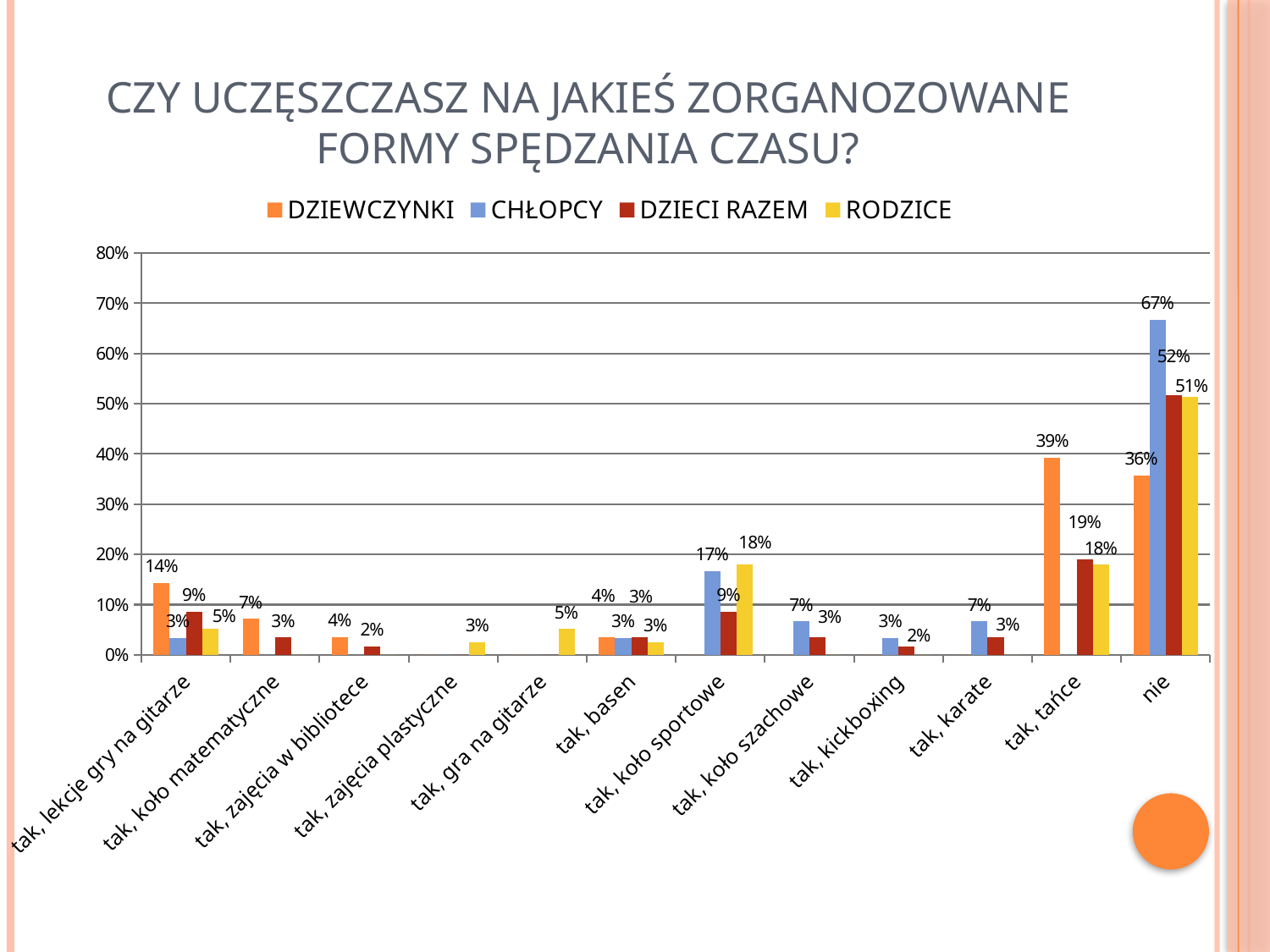
Which series is shown in yellow in the legend? RODZICE Which is larger in the category "tak, tańce": the DZIECI RAZEM value or the RODZICE value? DZIECI RAZEM How many series does the legend list? 4 What is the value for DZIEWCZYNKI in the category "tak, tańce"? 39% What is the value for DZIECI RAZEM in the category "tak, lekcje gry na gitarze"? 9% How many categories are shown on the x axis? 12 What is the value for RODZICE in the category "tak, koło sportowe"? 18% What type of chart is shown on the slide? bar chart What is the value for CHŁOPCY in the category "nie"? 67% Which category has the highest value for CHŁOPCY? nie Is the value for DZIECI RAZEM in the category "nie" greater or less than 50%? greater What is the difference between the CHŁOPCY and DZIEWCZYNKI values in the category "nie"? 31%